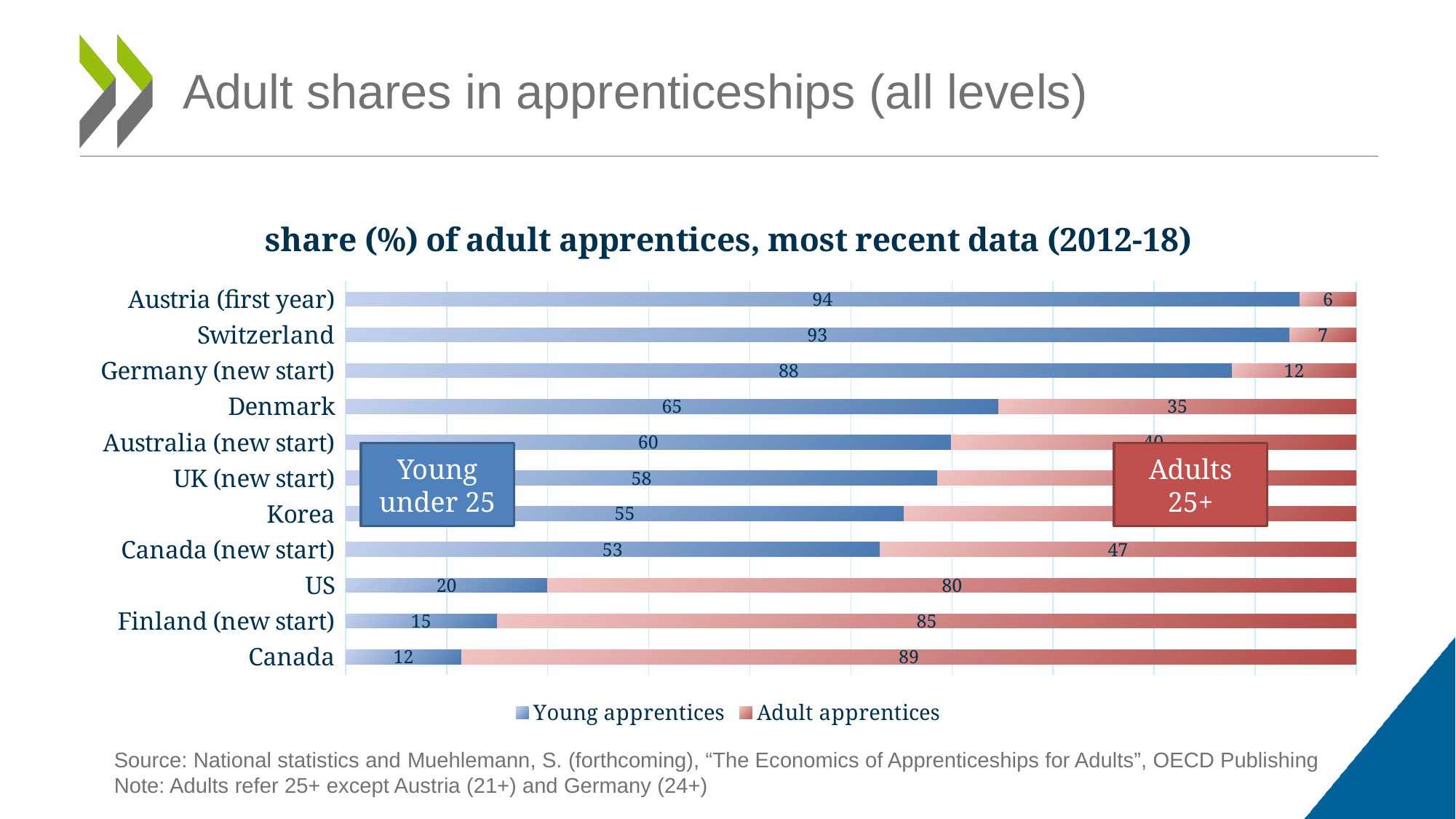
What is the value for Young apprentices for Denmark? 65 What is the total of the stacked bar for Canada (new start)? 100 For Finland (new start), what is the difference between the Adult apprentices value and the Young apprentices value? 70 What is the title of the chart? share (%) of adult apprentices, most recent data (2012-18) Which has a larger Young apprentices value, Denmark or Korea? Denmark How many series does the legend list? 2 What is the value for Adult apprentices for the US? 80 What is the value for Adult apprentices for Germany (new start)? 12 How many countries or categories are shown on the chart? 11 Which country has the lowest value for Young apprentices? Canada What kind of chart is shown on the slide? Stacked bar chart Which country has the highest value for Adult apprentices? Canada